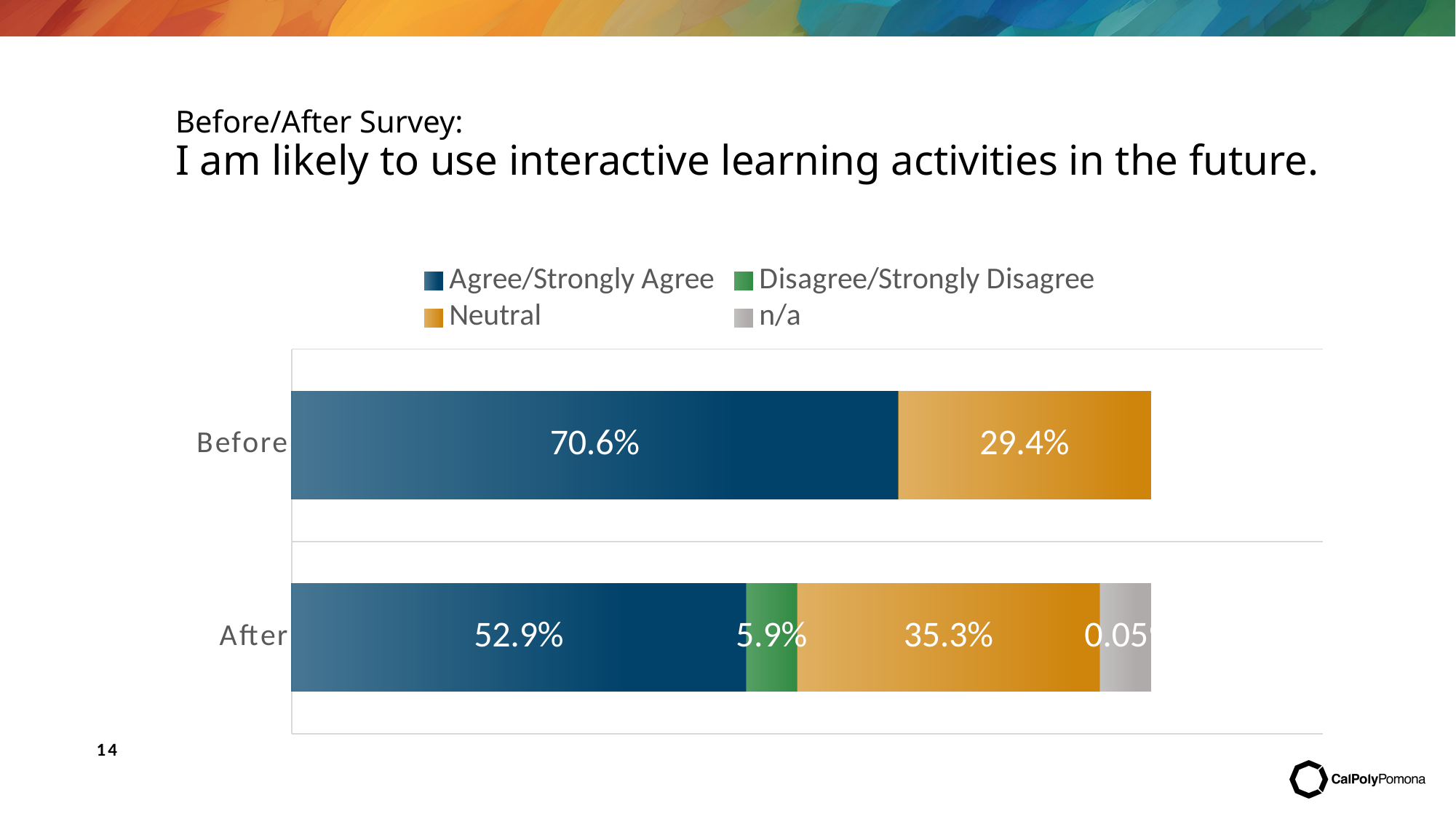
What percentage of respondents chose Neutral in the After survey? 35.3% What percentage of respondents chose Neutral in the Before survey? 29.4% What percentage of respondents chose Agree/Strongly Agree in the Before survey? 70.6% What kind of chart is shown on the slide? Stacked bar chart Which legend entry is shown in green? Disagree/Strongly Disagree By how many percentage points is the Neutral share higher in the After survey than in the Before survey? 5.9 Which survey, Before or After, has the higher Agree/Strongly Agree percentage? Before How many categories (bars) are shown on the chart? 2 What percentage of respondents chose Disagree/Strongly Disagree in the After survey? 5.9% What percentage of respondents chose Agree/Strongly Agree in the After survey? 52.9% By how many percentage points did the Agree/Strongly Agree share drop from Before to After? 17.7 How many series does the legend list? 4